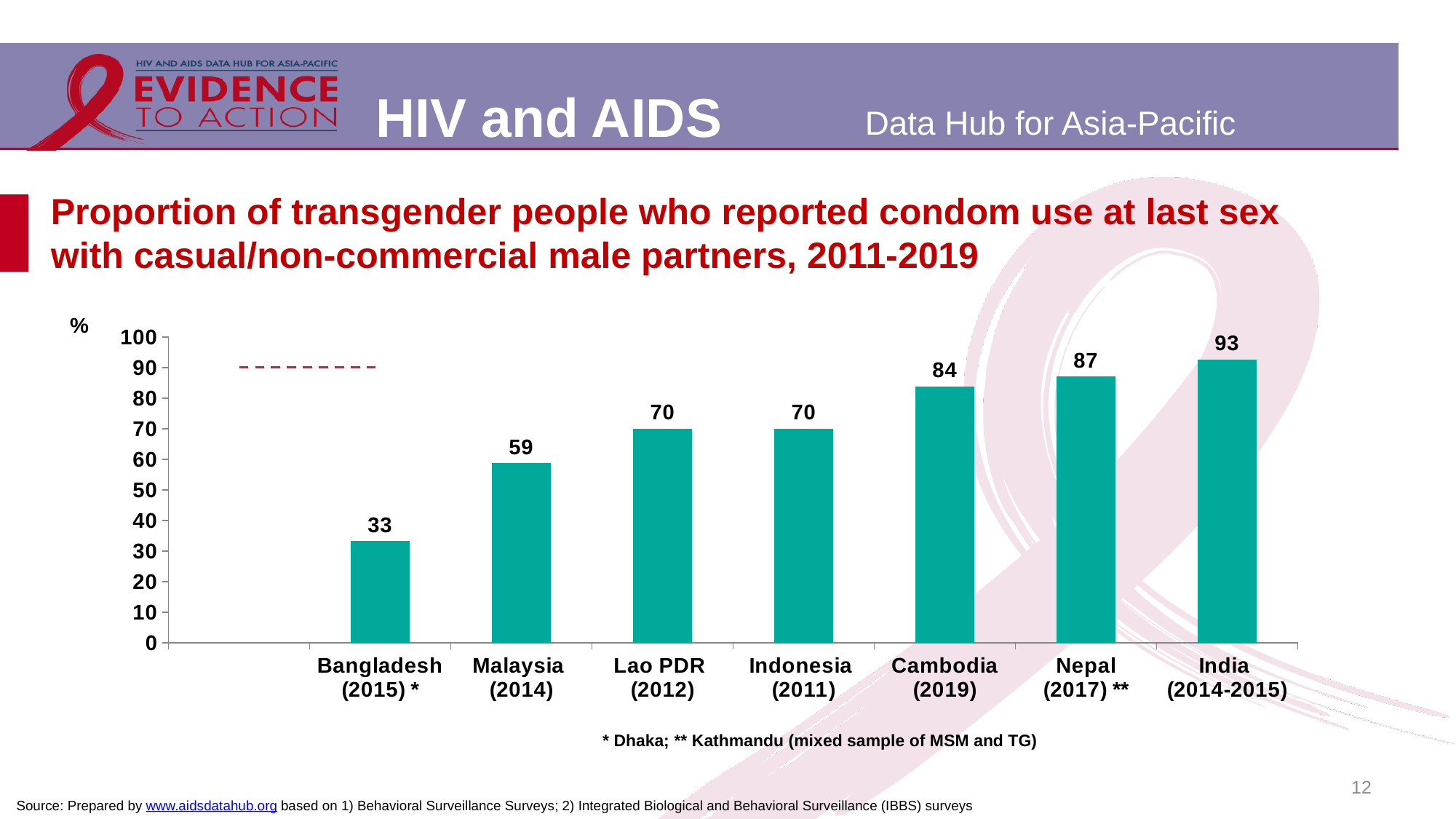
Which country has the highest value? India (2014-2015) What is the value for Bangladesh (2015)? 33 Which is larger, the value for Malaysia or the value for Cambodia? Cambodia What is the difference between the values for India and Bangladesh? 60 What is the value for Nepal (2017)? 87 Is the value for Indonesia greater or less than 60? greater What unit is shown on the y axis of the chart? % How many countries are shown on the chart? 7 What is the difference between the values for Malaysia and Lao PDR? 11 What kind of chart is shown on the slide? Bar chart Which country has the lowest value? Bangladesh (2015) What is the value for Cambodia (2019)? 84